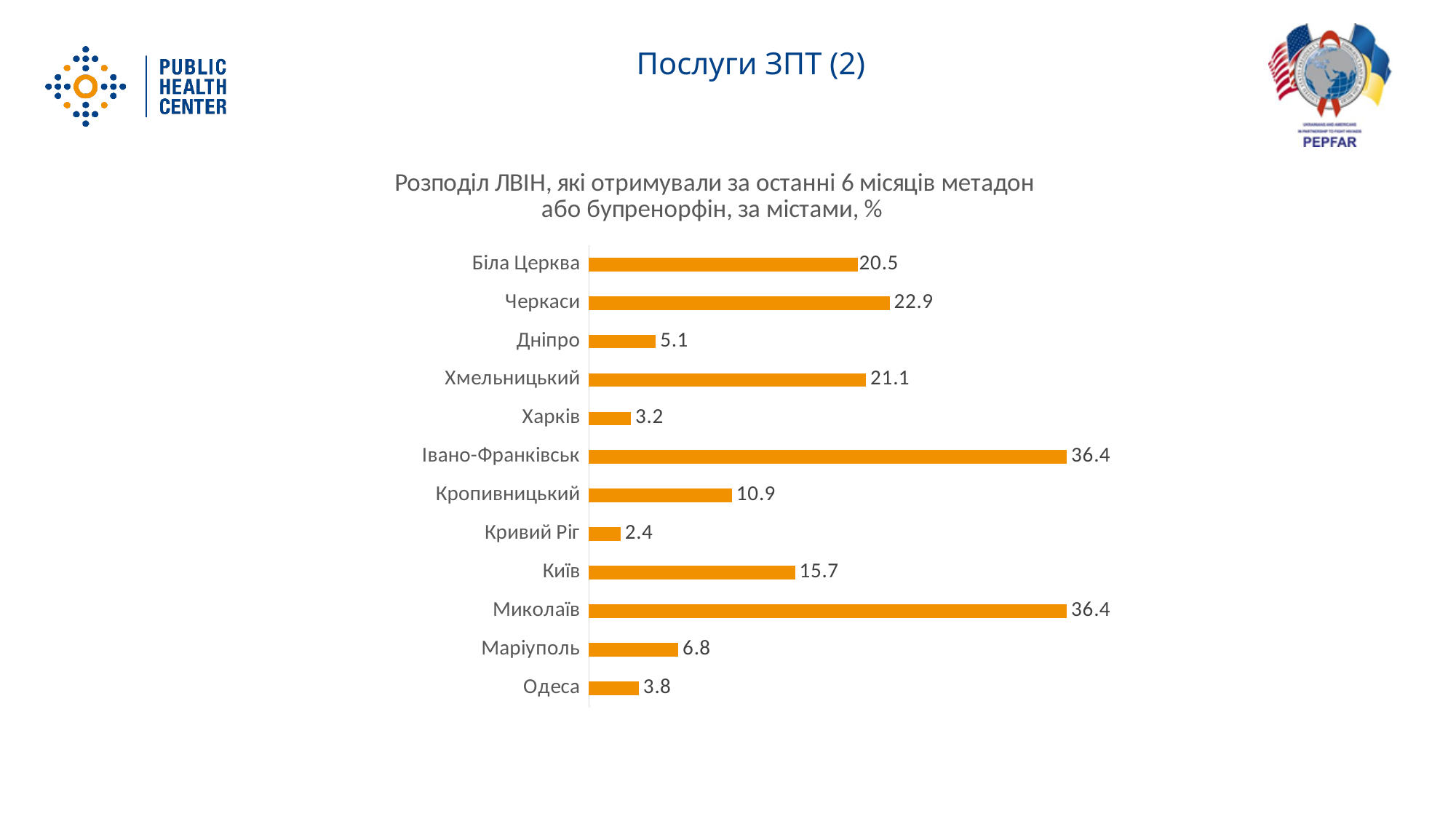
What is the difference between the values for Черкаси and Біла Церква? 2.4 What is the value for Харків? 3.2 What is the highest value shown in the chart? 36.4 Which has a larger value, Хмельницький or Маріуполь? Хмельницький What is the value for Київ? 15.7 What is the difference between the values for Київ and Кропивницький? 4.8 How many cities are shown in the chart? 12 What is the value for Черкаси? 22.9 What is the value for Кропивницький? 10.9 Which city has the lowest value? Кривий Ріг Which has a larger value, Дніпро or Одеса? Дніпро What kind of chart is shown on the slide? Bar chart